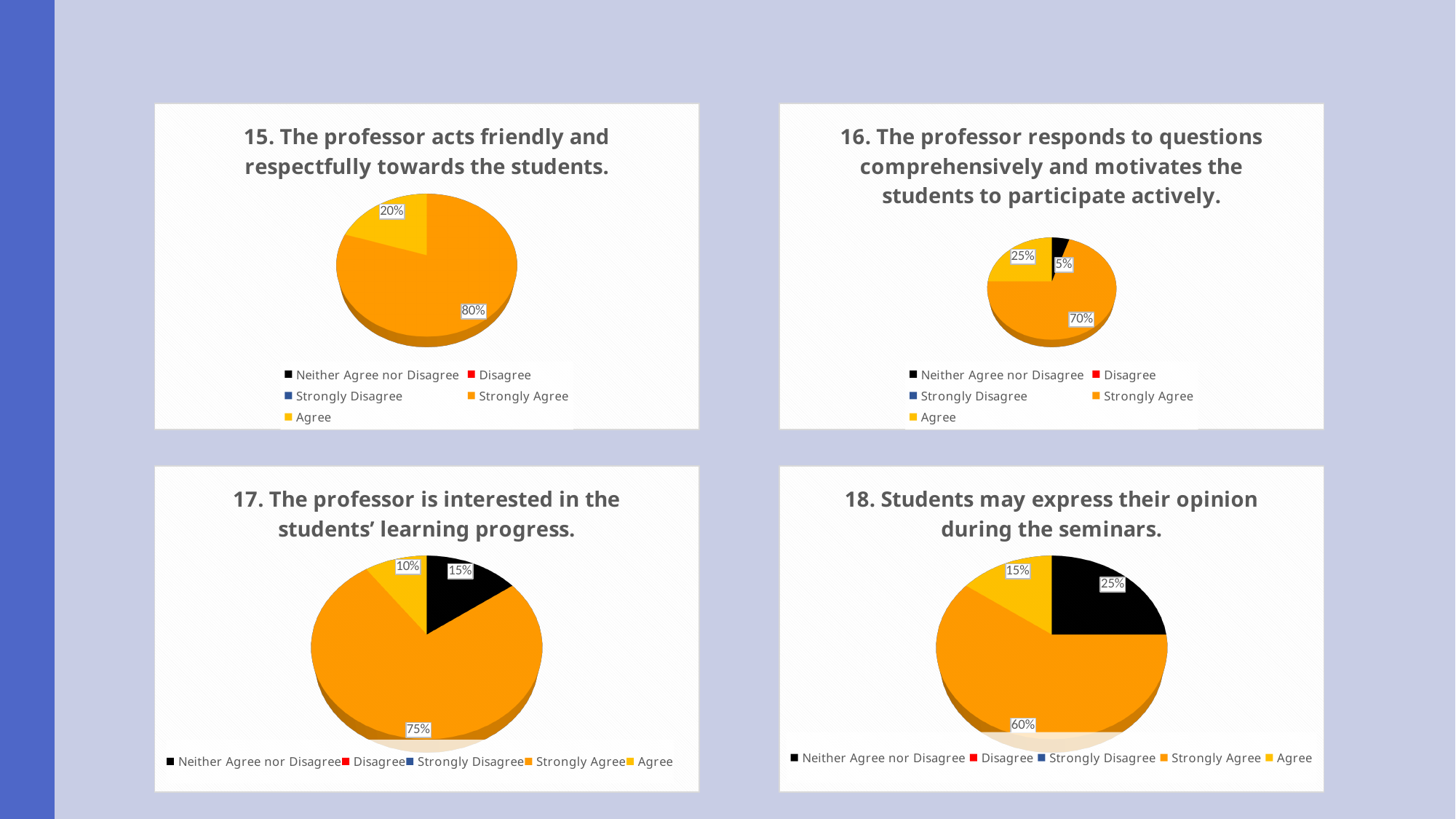
What type of chart is used for '17. The professor is interested in the students' learning progress.'? Pie chart In the chart titled '16. The professor responds to questions comprehensively and motivates the students to participate actively.', what percentage is shown for Neither Agree nor Disagree? 5% In the chart titled '18. Students may express their opinion during the seminars.', what percentage is shown for Strongly Agree? 60% In the chart titled '17. The professor is interested in the students' learning progress.', which response category has the smallest slice? Agree In the chart titled '18. Students may express their opinion during the seminars.', which is larger, Neither Agree nor Disagree or Agree? Neither Agree nor Disagree In the chart titled '15. The professor acts friendly and respectfully towards the students.', what percentage is shown for Agree? 20% In the chart titled '16. The professor responds to questions comprehensively and motivates the students to participate actively.', which response category has the largest slice? Strongly Agree In the chart titled '18. Students may express their opinion during the seminars.', what is the difference between the Strongly Agree and Neither Agree nor Disagree percentages? 35% In the chart titled '17. The professor is interested in the students' learning progress.', what percentage is shown for Neither Agree nor Disagree? 15% How many entries does the legend list in the chart titled '15. The professor acts friendly and respectfully towards the students.'? 5 In the chart titled '16. The professor responds to questions comprehensively and motivates the students to participate actively.', what is the difference between the Strongly Agree and Agree percentages? 45% In the chart titled '15. The professor acts friendly and respectfully towards the students.', what share of responses is Strongly Agree? 80%